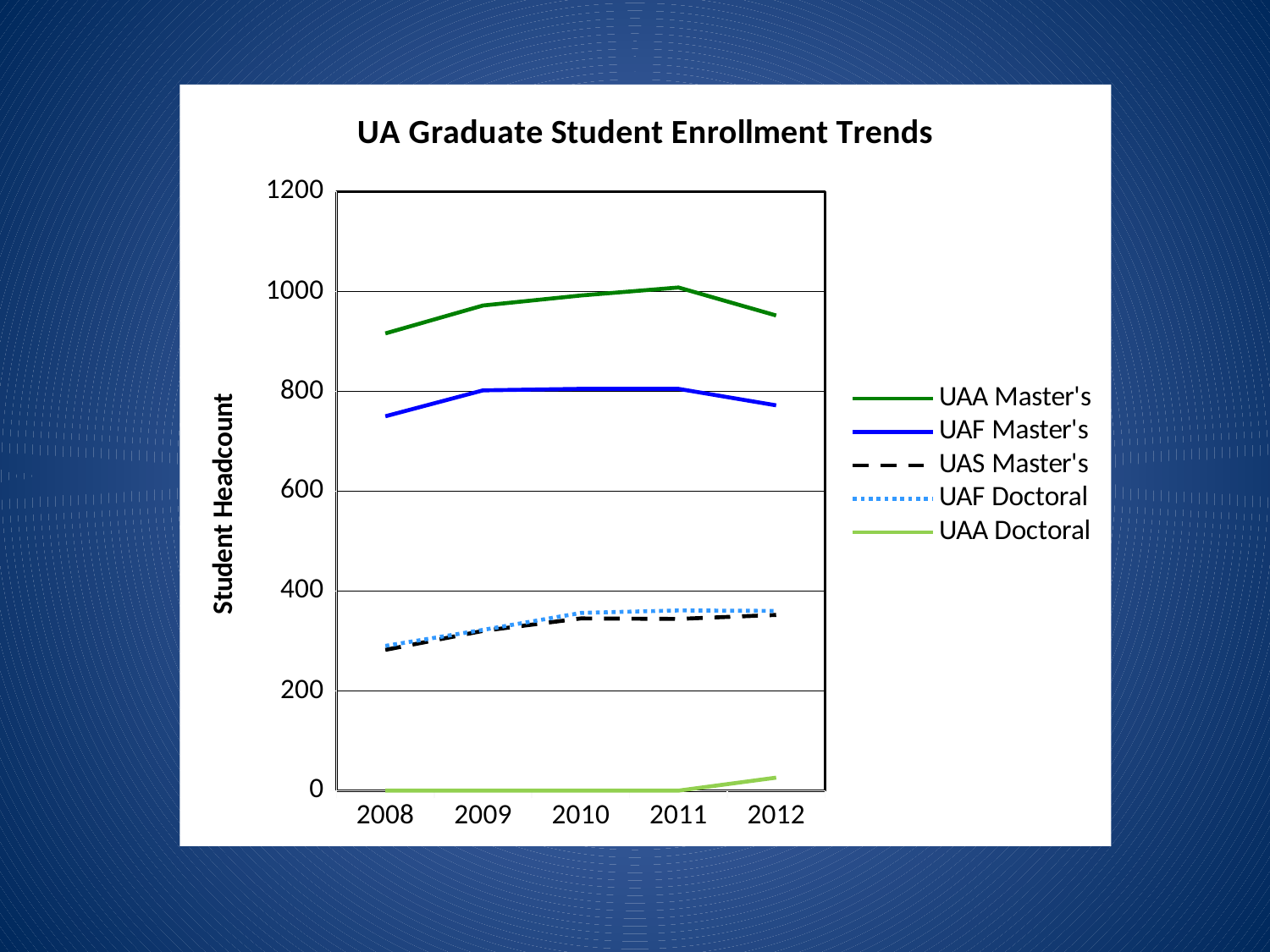
Which is larger in 2010, UAA Master's or UAF Master's? UAA Master's How many years are shown on the x axis? 5 Is the value for UAF Master's in 2012 greater or less than 800? less What is the label on the vertical axis? Student Headcount Is the value for UAS Master's in 2012 greater or less than 400? less What kind of chart is shown on the slide? line chart Does the UAF Master's line rise or fall from 2011 to 2012? fall How many series does the legend list? 5 Which series has the lowest value in 2008? UAA Doctoral Is the value for UAA Master's in 2008 greater or less than 1000? less What is the title of the chart? UA Graduate Student Enrollment Trends Which series has the highest value in 2011? UAA Master's